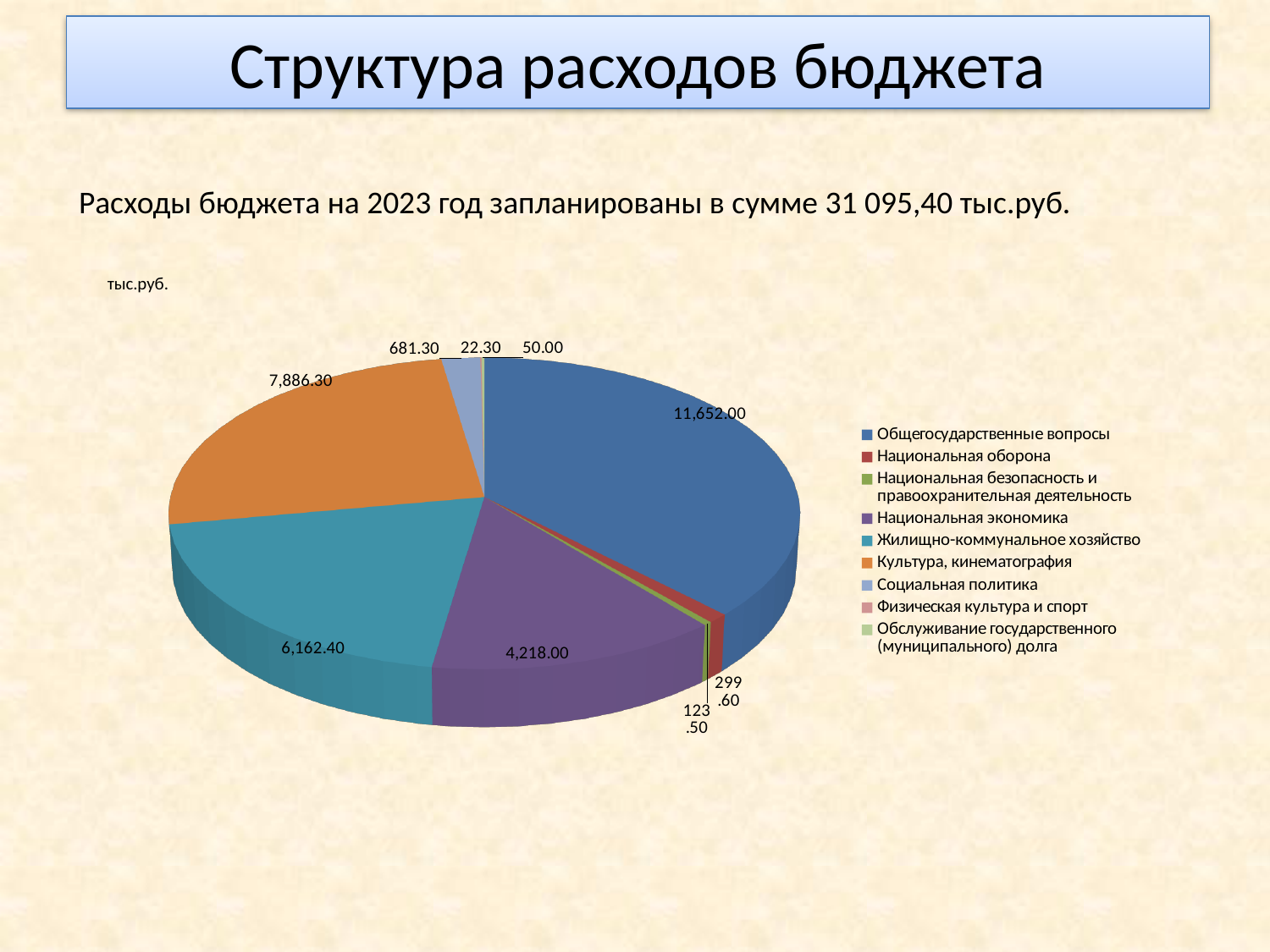
What is the value for Жилищно-коммунальное хозяйство? 6,162.40 What type of chart is shown on the slide? pie chart What is the value for Общегосударственные вопросы? 11,652.00 What is the value for Культура, кинематография? 7,886.30 Which is larger: Национальная экономика or Жилищно-коммунальное хозяйство? Жилищно-коммунальное хозяйство How many categories does the legend list? 9 What is the total of all slices in the pie chart? 31,095.40 Which category has the smallest slice of the pie? Физическая культура и спорт What is the value for Социальная политика? 681.30 What unit is indicated above the chart? тыс.руб. Which category has the largest slice of the pie? Общегосударственные вопросы What is the difference between the values for Культура, кинематография and Жилищно-коммунальное хозяйство? 1,723.90